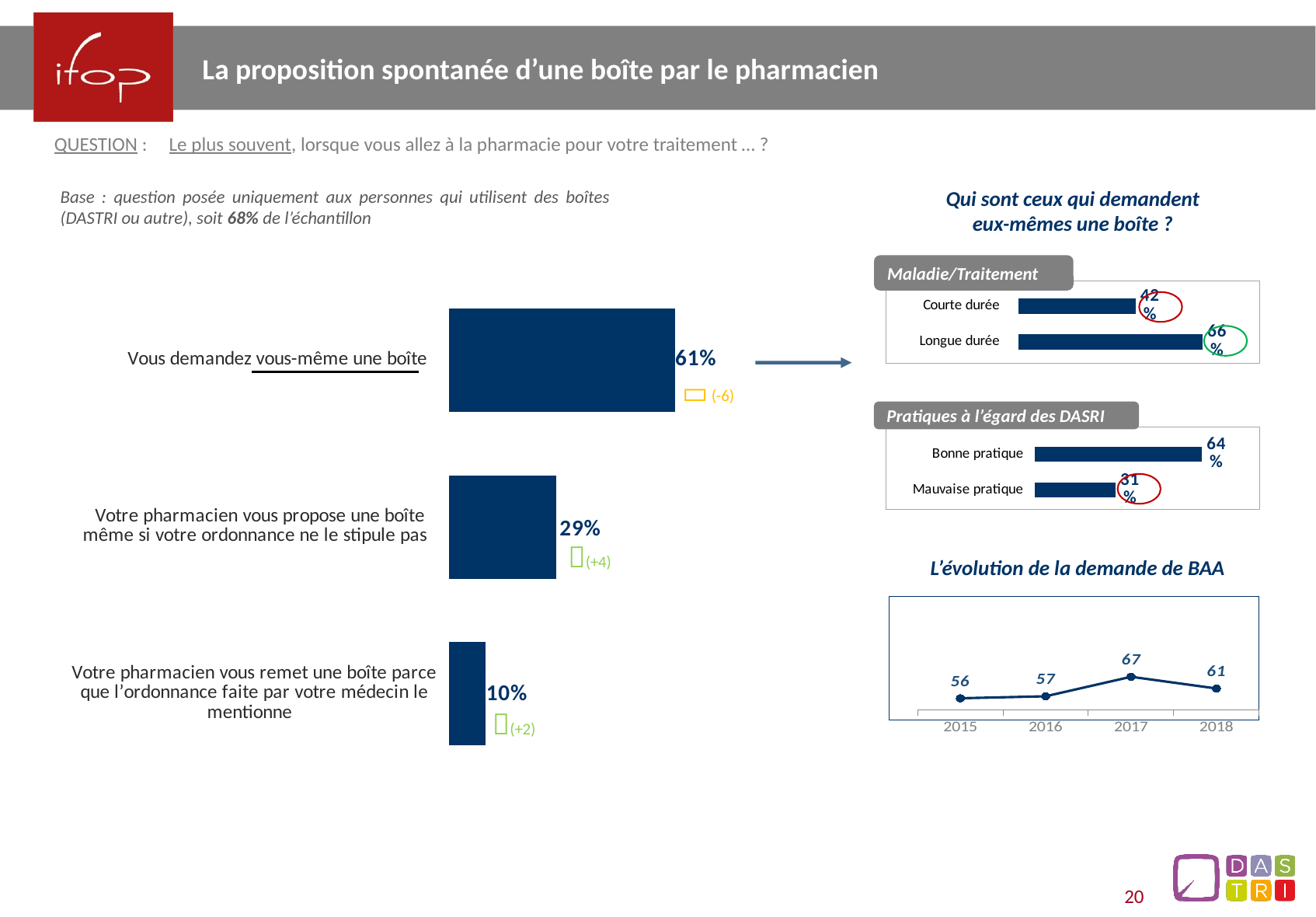
In the main bar chart on the left, what is the difference between the highest and lowest values? 51 percentage points In the chart "L'évolution de la demande de BAA", which year has the highest value? 2017 In the "Maladie/Traitement" chart, what is the value for "Longue durée"? 66% In the "Pratiques à l'égard des DASRI" chart, what is the value for "Mauvaise pratique"? 31% In the chart "L'évolution de la demande de BAA", what is the value for 2017? 67 In the main bar chart on the left, which category has the lowest value? Votre pharmacien vous remet une boîte parce que l'ordonnance faite par votre médecin le mentionne In the main bar chart on the left, how many categories are shown? 3 In the main bar chart on the left, what is the value for "Votre pharmacien vous propose une boîte même si votre ordonnance ne le stipule pas"? 29% In the "Pratiques à l'égard des DASRI" chart, what is the difference between "Bonne pratique" and "Mauvaise pratique"? 33 percentage points In the main bar chart on the left, what is the value for "Vous demandez vous-même une boîte"? 61% In the "Maladie/Traitement" chart, which is larger, "Courte durée" or "Longue durée"? Longue durée In the chart "L'évolution de la demande de BAA", what kind of chart is it? Line chart